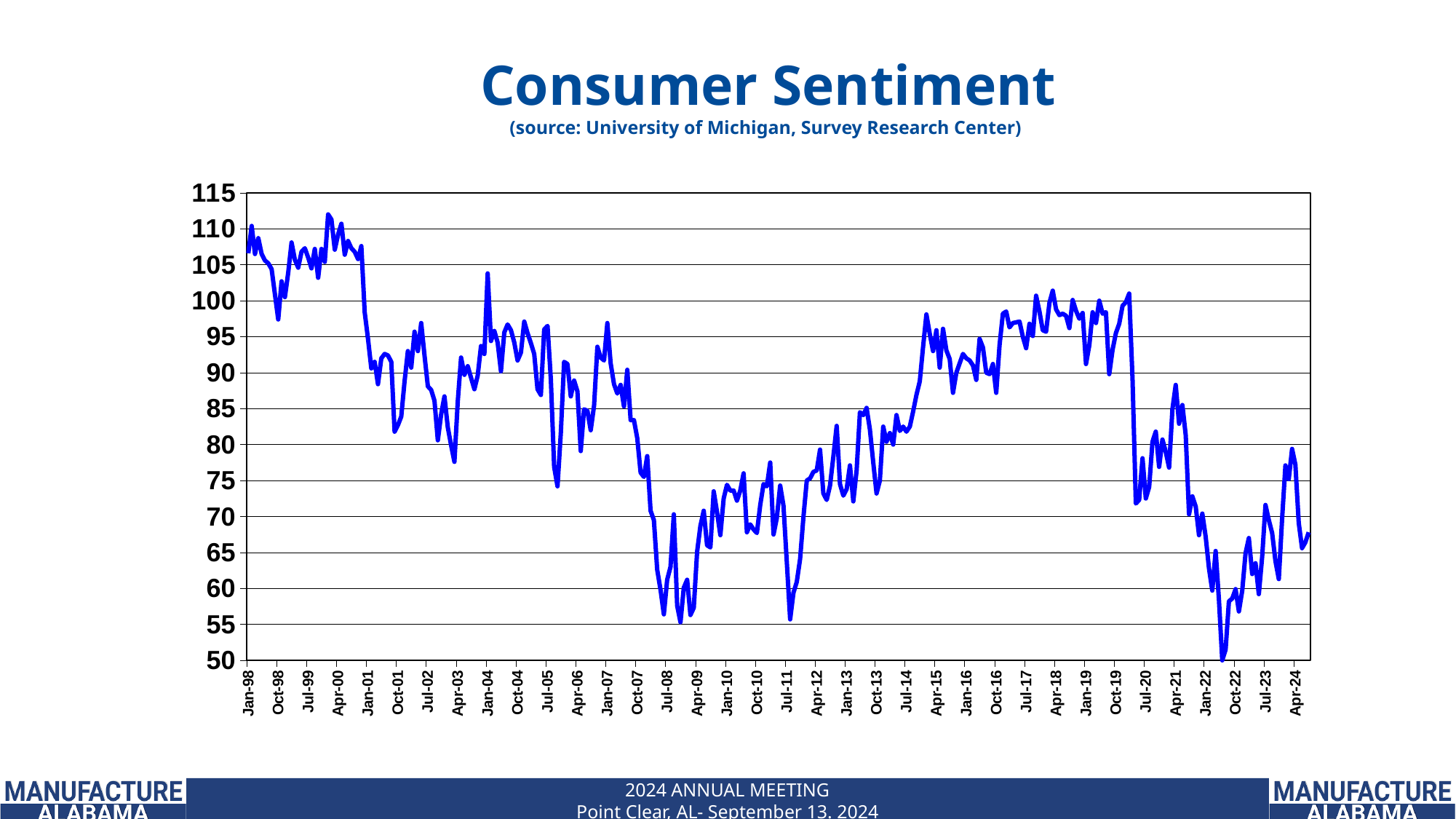
What is the highest value shown on the vertical axis? 115 What kind of chart is shown on the slide? line chart Is the value for Jan-98 greater or less than 100? greater Is the value for Jan-22 greater or less than 75? less Is the value for Jul-11 greater or less than 60? greater What source is cited for the chart's data? University of Michigan, Survey Research Center What is the title of the chart? Consumer Sentiment Does consumer sentiment generally rise or fall between Jul-11 and Apr-18? rise Overall, does consumer sentiment rise or fall from Jan-98 to Apr-24? fall